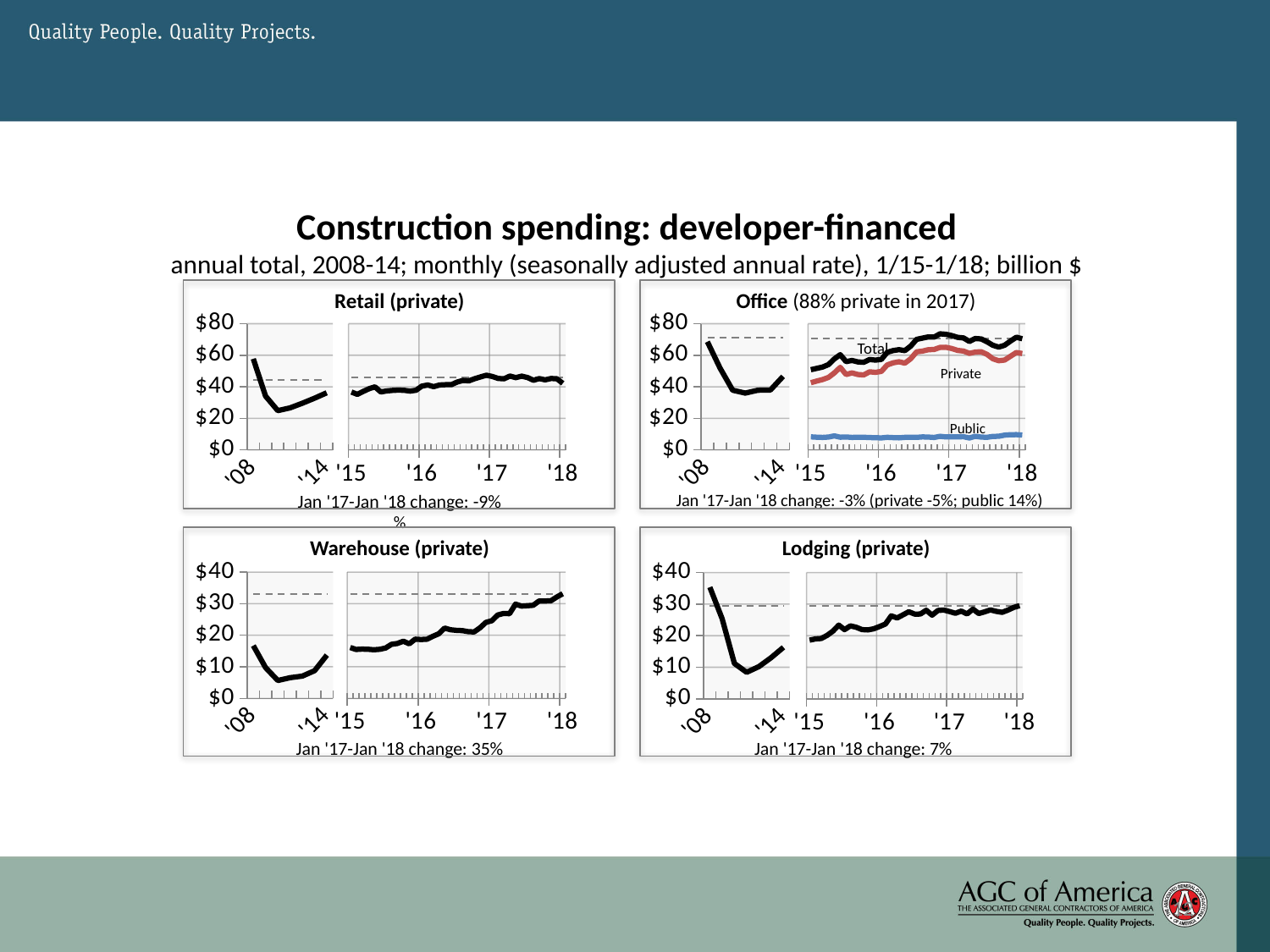
How many charts are shown on the slide? 4 In the Retail (private) chart, what is the Jan '17-Jan '18 change? -9% In the Office chart, what is the Jan '17-Jan '18 change for public spending? 14% In the Office chart, what is the Jan '17-Jan '18 change for the total? -3% In the Office chart, which series is larger in 2017, Private or Public? Private In the Lodging (private) chart, what is the Jan '17-Jan '18 change? 7% Which of the four charts reports the largest Jan '17-Jan '18 change? Warehouse (private) In the Office chart, how many series are plotted? 3 What kind of chart is used in the Retail (private) panel? line chart In the Warehouse (private) chart, do values rise or fall from '15 to '18? rise In the Warehouse (private) chart, what is the Jan '17-Jan '18 change? 35% In the Retail (private) chart, is the value for 2008 greater or less than $40? greater